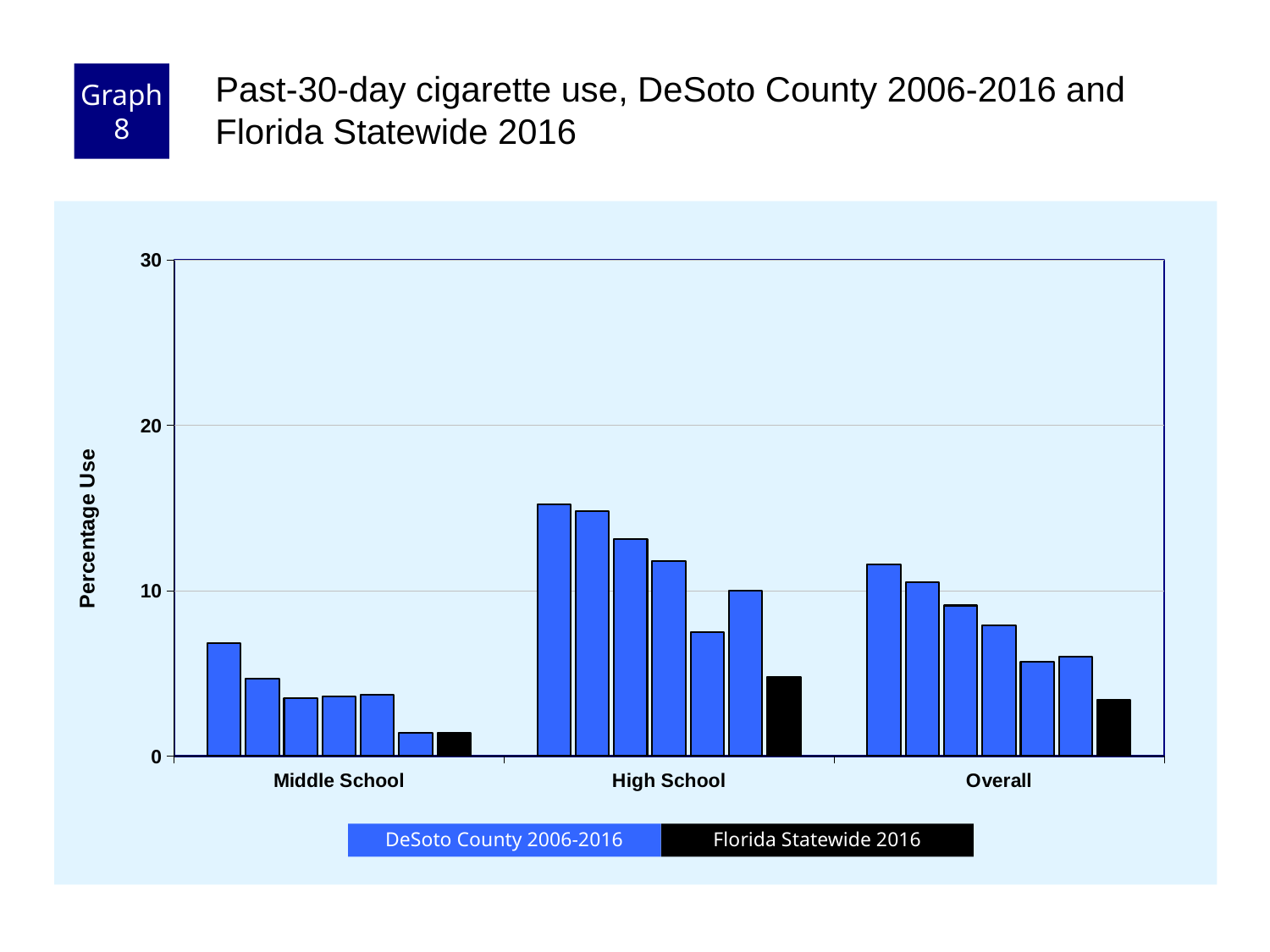
Is the tallest DeSoto County bar for High School greater or less than 10? greater Which is larger: the Florida Statewide 2016 value for High School or for Middle School? High School Is the Florida Statewide 2016 value for High School greater or less than 10? less Which category has the shortest bars overall? Middle School Is the tallest DeSoto County bar for High School greater or less than 20? less What is the label on the y axis? Percentage Use Which category has the tallest bars overall? High School How many categories are shown on the x axis? 3 How many series does the legend list? 2 What kind of chart is shown on the slide? Bar chart